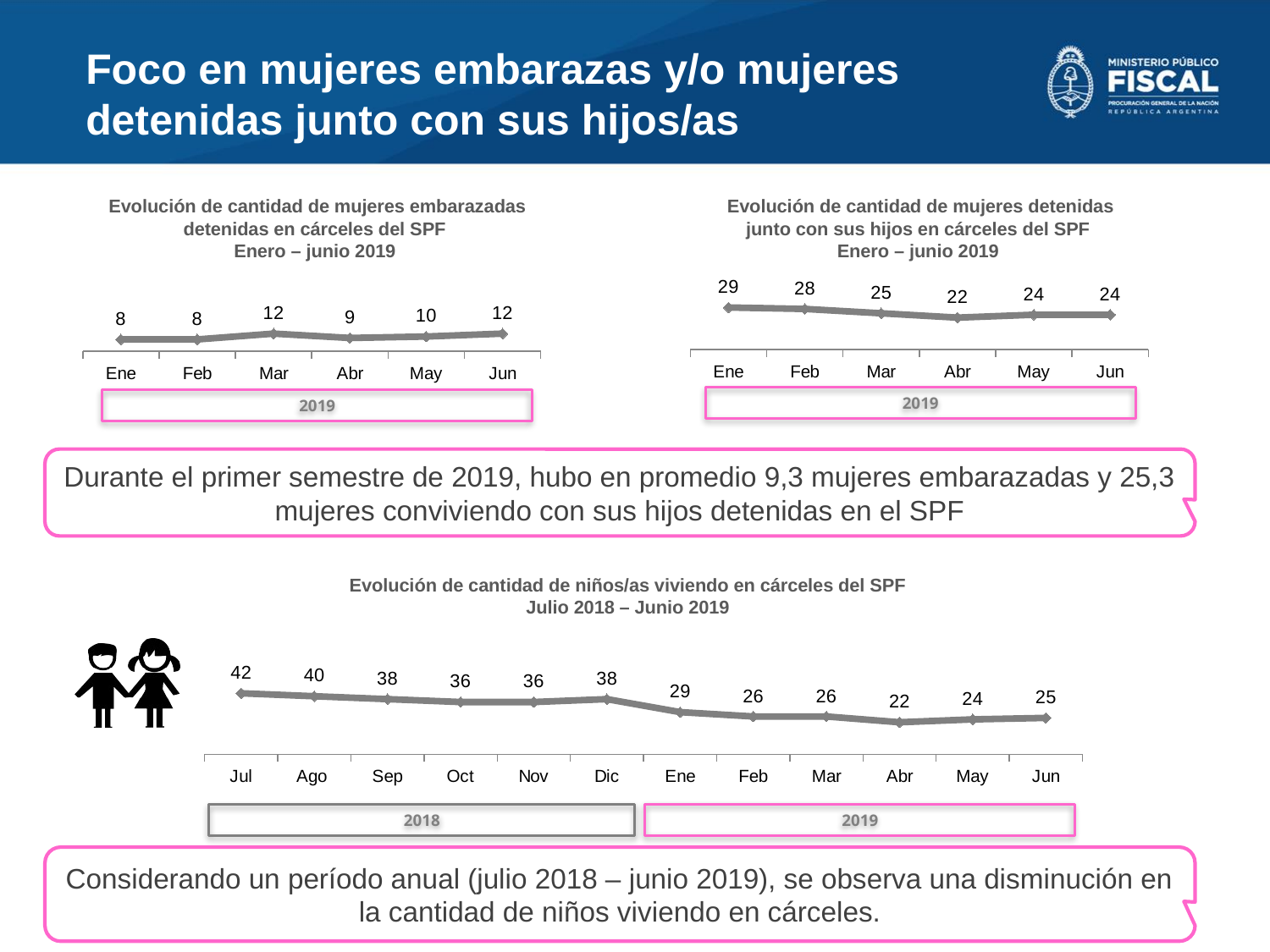
In the top-left chart (mujeres embarazadas detenidas), what is the value for Mar? 12 In the top-right chart (mujeres detenidas junto con sus hijos), which month has the lowest value? Abr In the bottom chart (niños/as viviendo en cárceles del SPF), which month has the lowest value? Abr In the bottom chart (niños/as viviendo en cárceles del SPF), what is the value for Jul? 42 In the bottom chart (niños/as viviendo en cárceles del SPF), how many data points are plotted? 12 In the bottom chart (niños/as viviendo en cárceles del SPF), is the value for Dic larger or smaller than the value for Ene? larger In the top-right chart (mujeres detenidas junto con sus hijos), what is the difference between the values for Ene and Jun? 5 In the top-left chart (mujeres embarazadas detenidas), what is the difference between the values for Jun and Abr? 3 What type of chart is the bottom chart (niños/as viviendo en cárceles del SPF)? line chart In the top-left chart (mujeres embarazadas detenidas), which month has the lowest value? Ene and Feb (8) In the top-right chart (mujeres detenidas junto con sus hijos), what is the value for Ene? 29 In the bottom chart (niños/as viviendo en cárceles del SPF), do the values generally rise or fall from Jul to Jun? fall